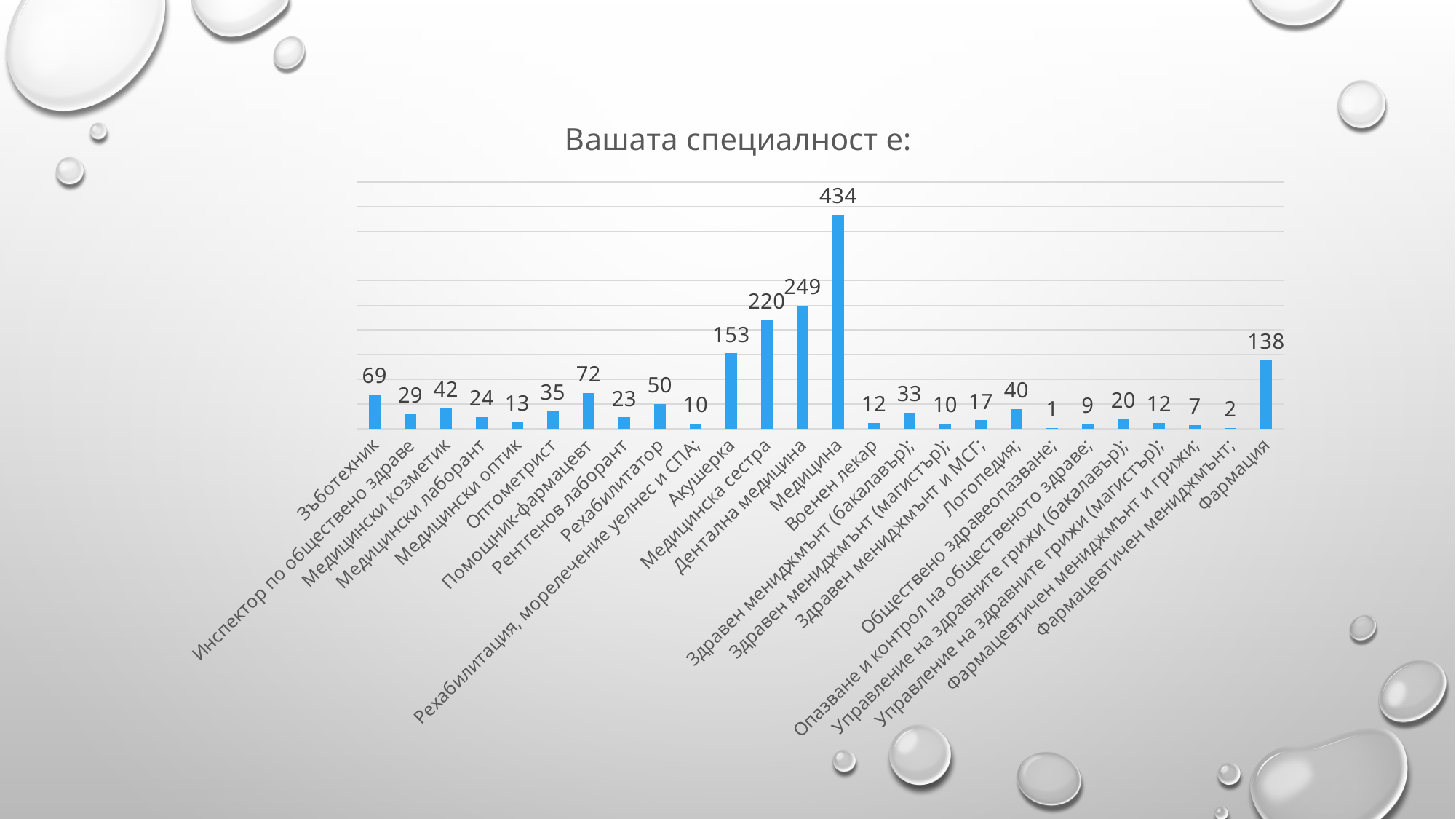
How many categories are shown on the x axis? 26 Which category has the highest value? Медицина Which is larger, the value for Зъботехник or the value for Рехабилитатор? Зъботехник What is the value for Фармация? 138 What is the difference between the values for Медицина and Фармация? 296 What is the value for Акушерка? 153 What is the title of the chart? Вашата специалност е: Which category has the lowest value? Обществено здравеопазване; What is the difference between the values for Дентална медицина and Медицинска сестра? 29 What kind of chart is this? Bar chart What is the value for Помощник-фармацевт? 72 What is the value for Медицина? 434